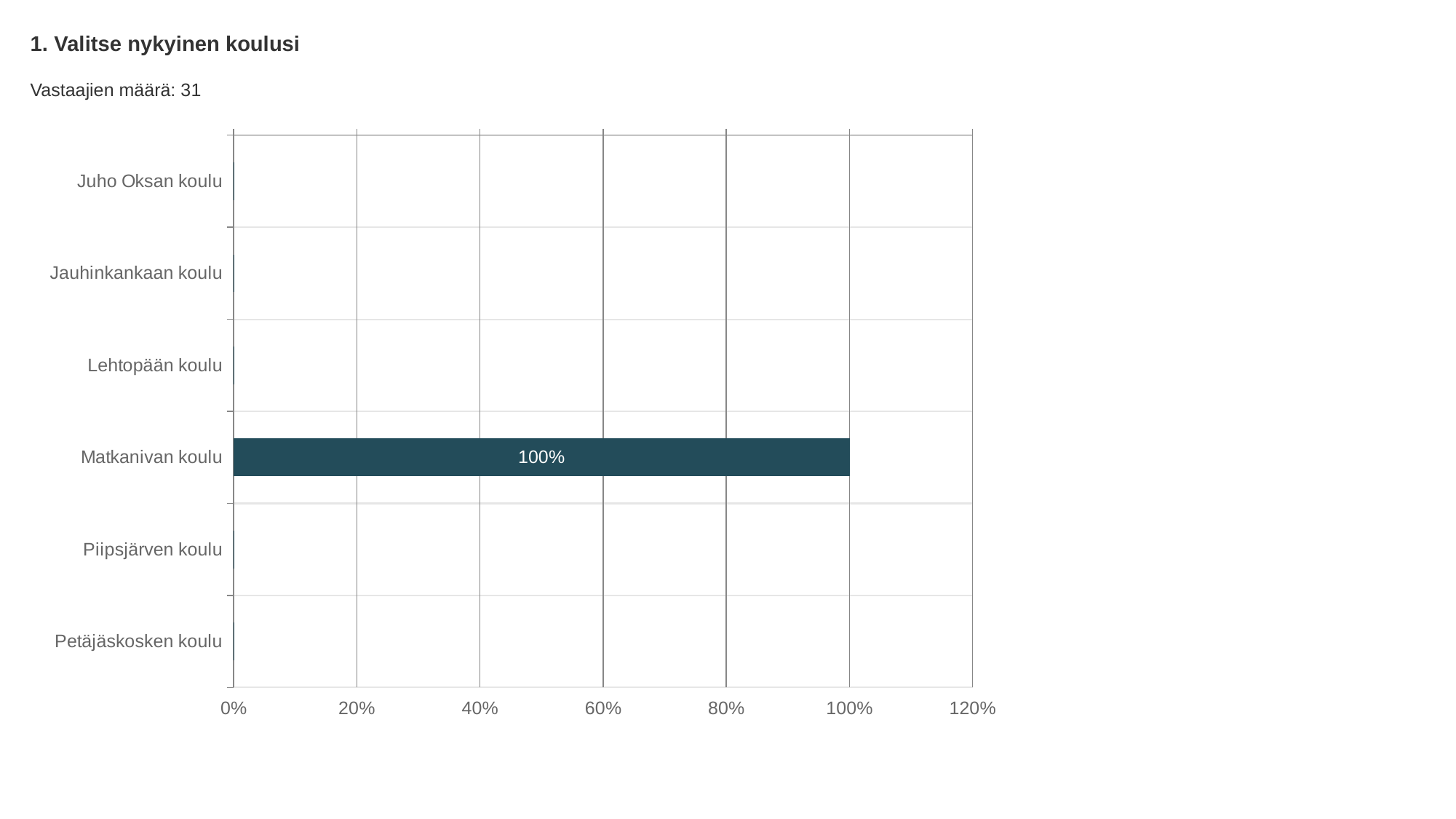
How many respondents (Vastaajien määrä) are reported on the slide? 31 What is the title of the chart? 1. Valitse nykyinen koulusi What is the highest tick value shown on the horizontal axis? 120% Which category has the highest value? Matkanivan koulu What is the value for Matkanivan koulu? 100% Is the value for Matkanivan koulu greater or less than 80%? greater What kind of chart is shown on the slide? bar chart Which is larger, the value for Matkanivan koulu or the value for Juho Oksan koulu? Matkanivan koulu How many categories are listed on the vertical axis? 6 Which category is listed first (at the top) on the vertical axis? Juho Oksan koulu